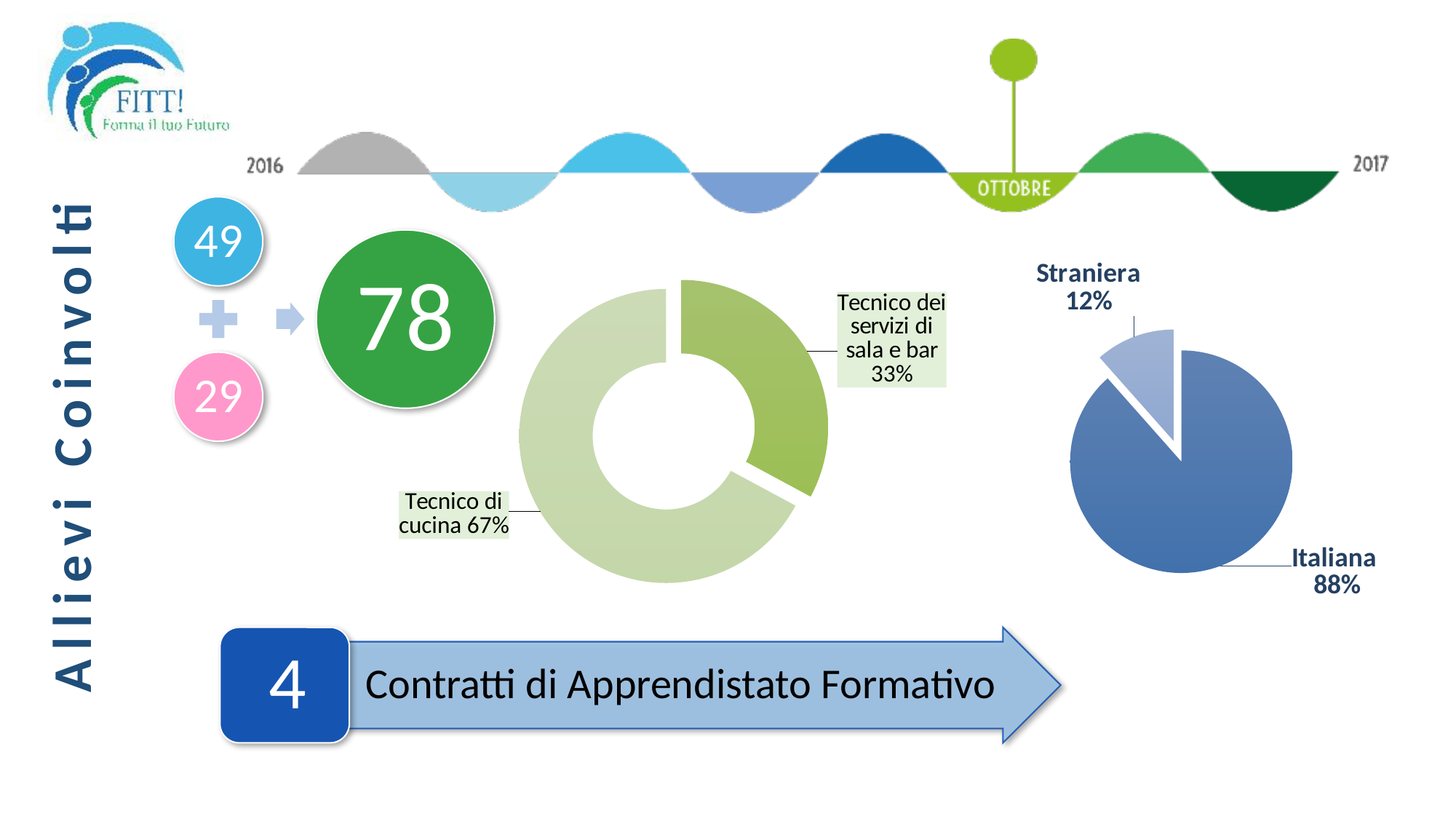
In the pie chart on the right of the slide, what share is shown for Italiana? 88% In the doughnut chart in the centre of the slide, which category has the largest share? Tecnico di cucina In the pie chart on the right of the slide, which slice is larger, Italiana or Straniera? Italiana In the doughnut chart in the centre of the slide, what share is shown for Tecnico dei servizi di sala e bar? 33% In the doughnut chart in the centre of the slide, what is the difference in percentage points between Tecnico di cucina and Tecnico dei servizi di sala e bar? 34 In the pie chart on the right of the slide, what share is shown for Straniera? 12% How many categories does the doughnut chart in the centre of the slide show? 2 In the pie chart on the right of the slide, what is the difference in percentage points between Italiana and Straniera? 76 In the doughnut chart in the centre of the slide, which category has the smallest share? Tecnico dei servizi di sala e bar In the doughnut chart in the centre of the slide, what share is shown for Tecnico di cucina? 67% What kind of chart is the chart on the right of the slide? Pie chart What kind of chart is the chart in the centre of the slide? Doughnut chart